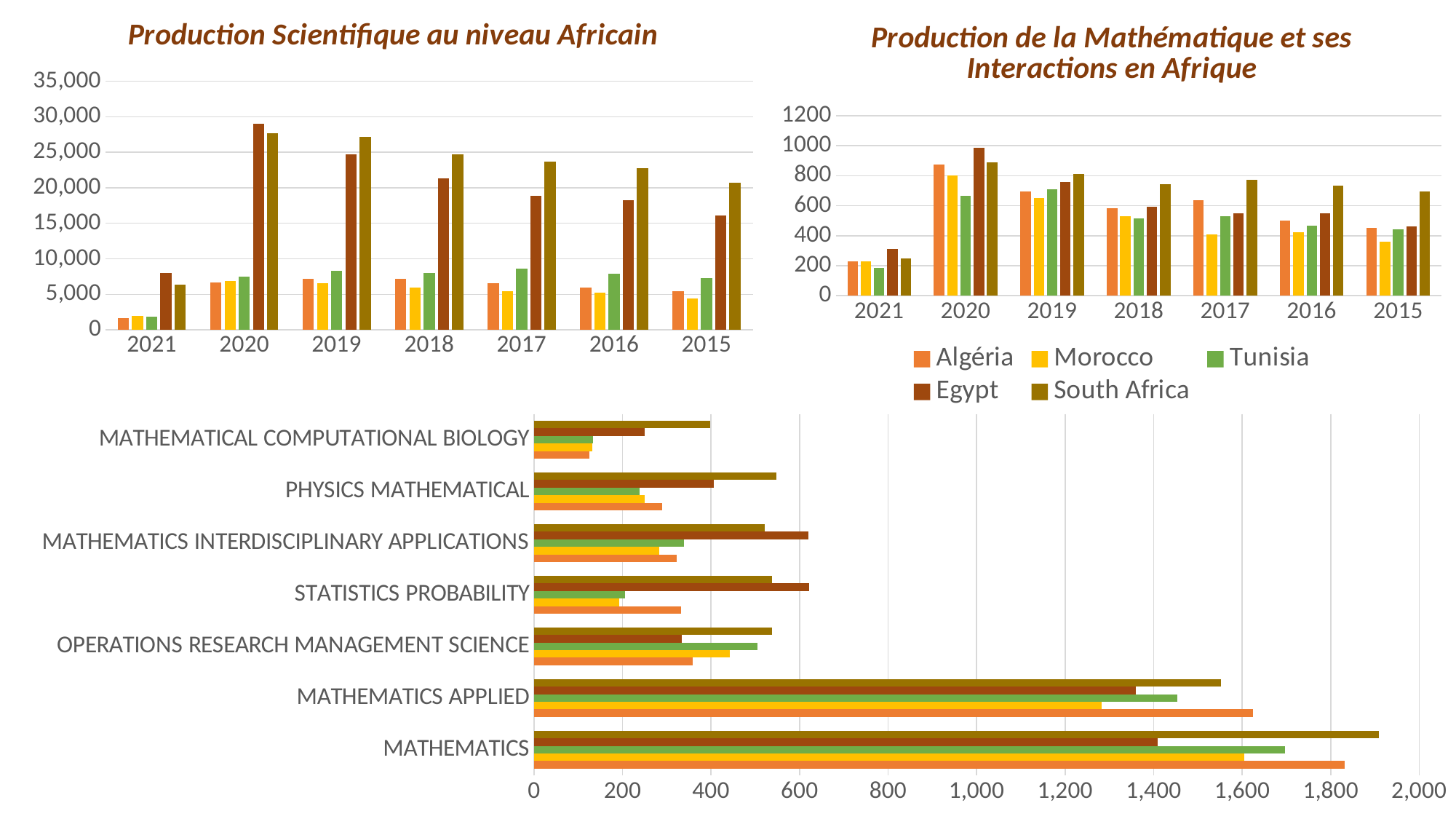
What kind of chart is the 'Production Scientifique au niveau Africain' chart? bar chart In the 'Production Scientifique au niveau Africain' chart, is the value for Egypt in 2020 greater or less than 25,000? greater In the 'Production Scientifique au niveau Africain' chart, which is larger in 2019: South Africa or Egypt? South Africa In the bottom horizontal bar chart, how many categories are listed on the vertical axis? 7 In the bottom horizontal bar chart, which is larger for MATHEMATICS APPLIED: Algéria or Egypt? Algéria In the 'Production de la Mathématique et ses Interactions en Afrique' chart, which country has the highest bar in 2020? Egypt In the 'Production de la Mathématique et ses Interactions en Afrique' chart, is the value for Algéria in 2021 greater or less than 400? less In the 'Production Scientifique au niveau Africain' chart, in which year is the Egypt bar highest? 2020 How many series does the legend list for the 'Production de la Mathématique et ses Interactions en Afrique' chart? 5 In the bottom horizontal bar chart, which category has the longest South Africa bar? MATHEMATICS In the 'Production Scientifique au niveau Africain' chart, is the value for Algéria in 2021 greater or less than 5,000? less In the 'Production Scientifique au niveau Africain' chart, how many years are shown on the x axis? 7